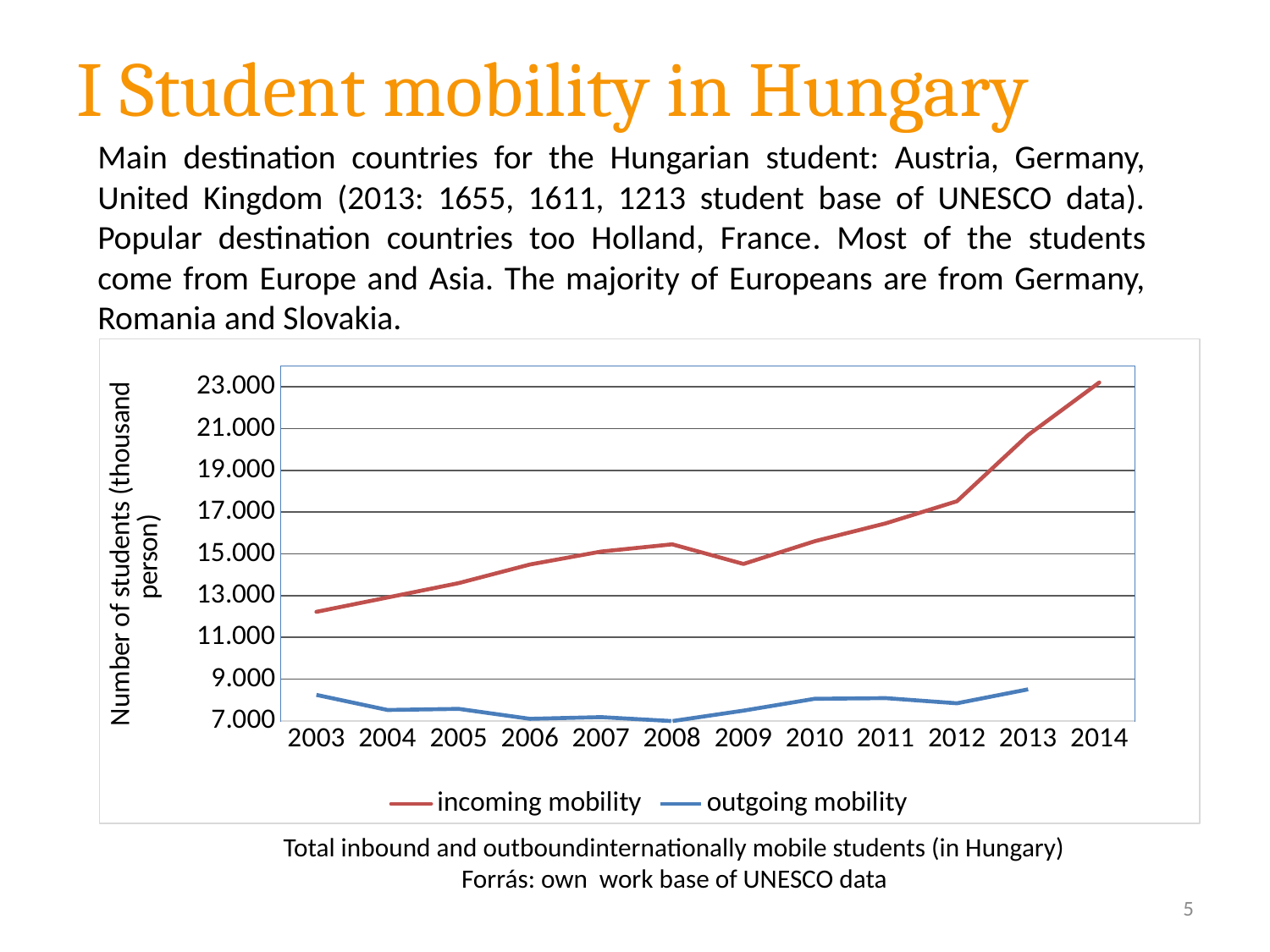
In 2010, which is larger: incoming mobility or outgoing mobility? incoming mobility How many series does the chart legend list? 2 What kind of chart is shown on the slide? line chart Is the value for incoming mobility in 2014 greater or less than 21.000? greater Is the value for incoming mobility in 2009 greater or less than 15.000? less Is the value for outgoing mobility in 2013 greater or less than 9.000? less In which year is incoming mobility at its highest? 2014 In which year is incoming mobility at its lowest? 2003 How many years are shown on the x axis of the chart? 12 Does incoming mobility generally rise or fall from 2003 to 2014? rise What is the label on the vertical axis of the chart? Number of students (thousand person)